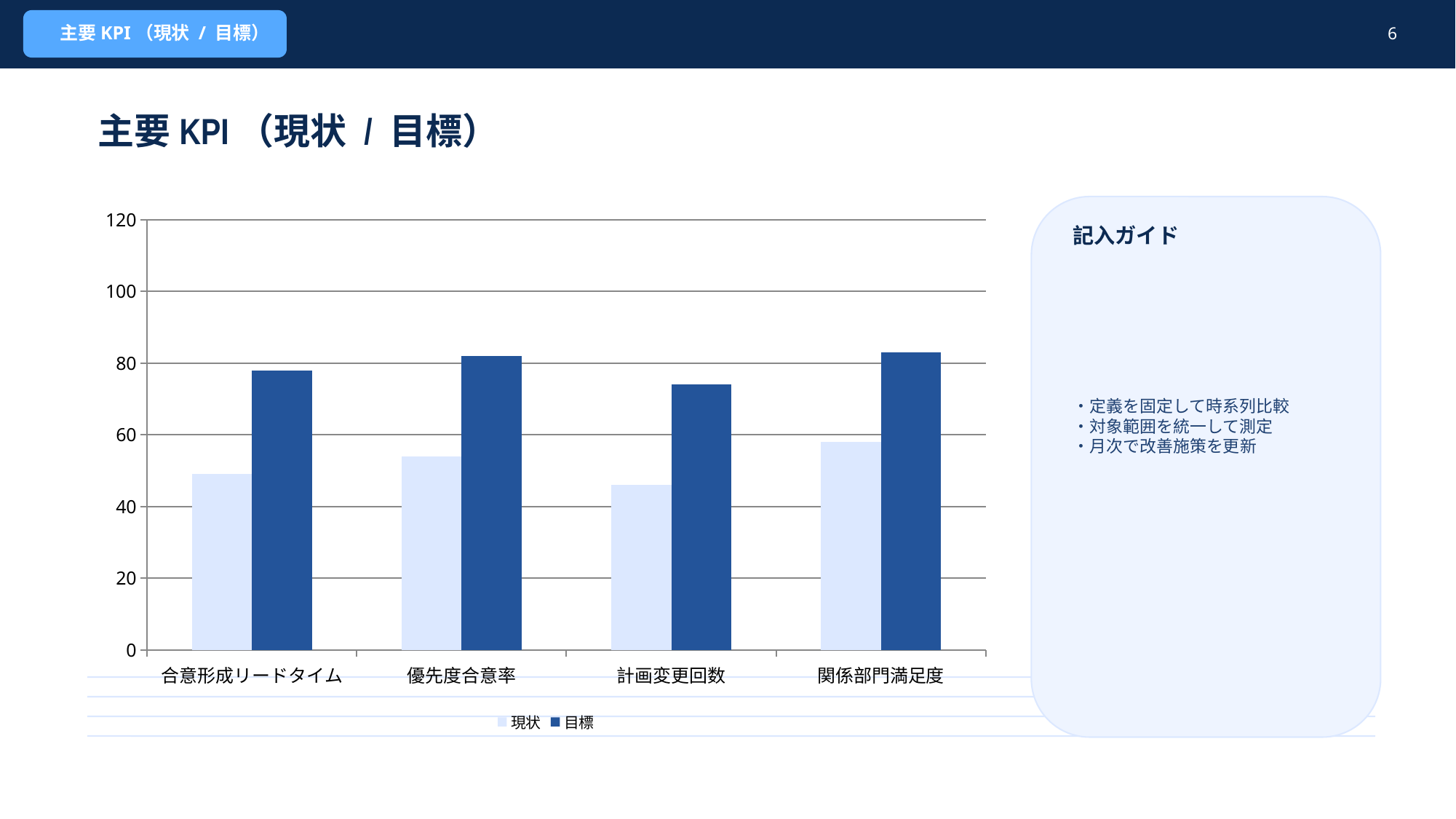
Is the 目標 value for 計画変更回数 greater or less than 60? greater Is the 目標 value for 関係部門満足度 greater or less than 100? less Which category has the lowest 目標 value? 計画変更回数 What kind of chart is shown on the slide? bar chart Is the 現状 value for 計画変更回数 greater or less than 60? less What is the title of the chart slide? 主要 KPI（現状 / 目標） How many categories are shown on the x axis of the chart? 4 How many series does the chart legend list? 2 What are the two series named in the chart legend? 現状 and 目標 For 優先度合意率, which is larger, the 現状 value or the 目標 value? 目標